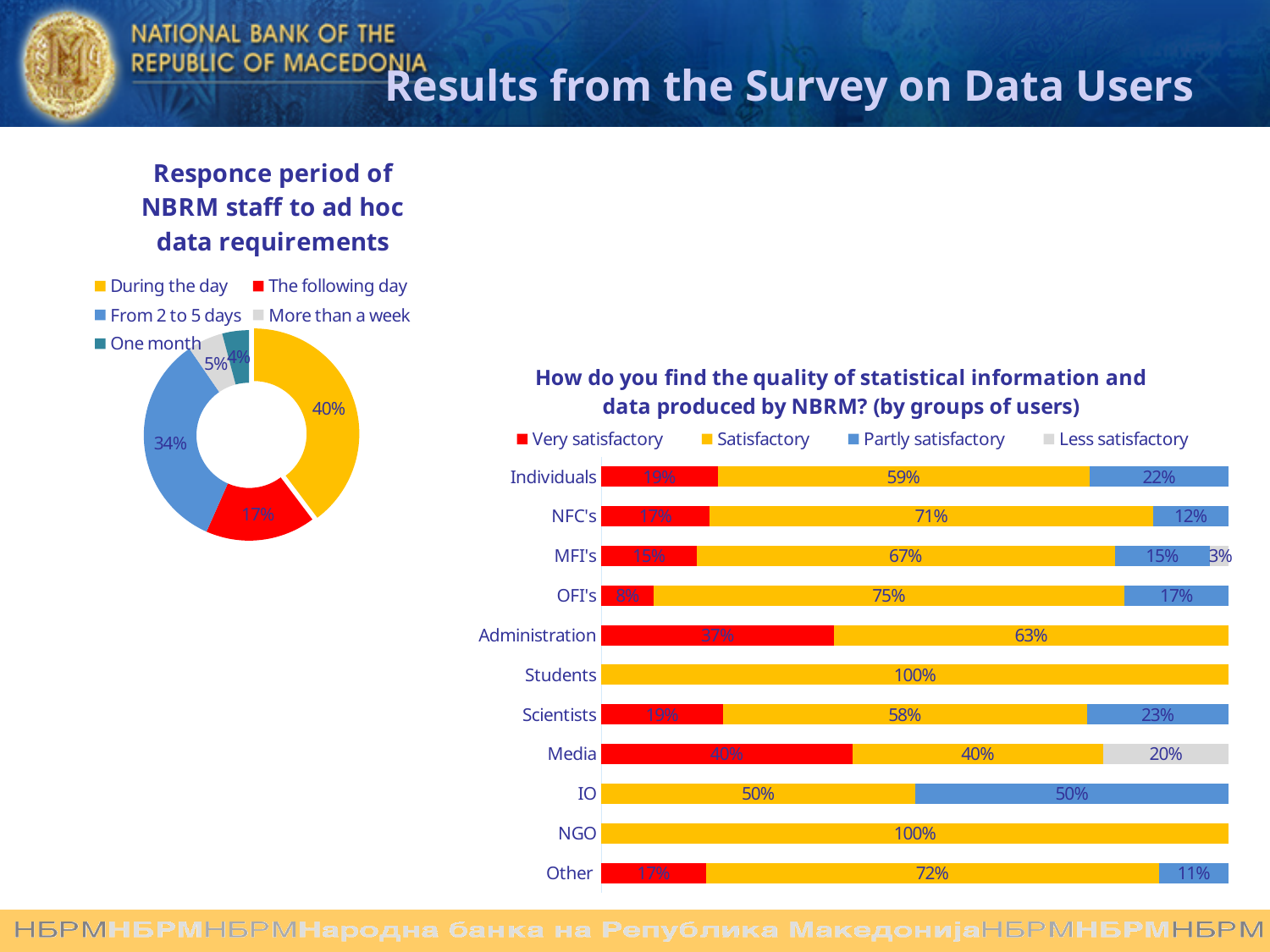
What type of chart is shown on the right of the slide? Stacked bar chart In the stacked bar chart on the right, which group has the highest 'Satisfactory' value among Individuals, NFC's, MFI's and OFI's? OFI's In the stacked bar chart on the right, is the 'Very satisfactory' value for Media larger or smaller than that for Scientists? larger In the doughnut chart on the left, which response period has the smallest share? One month In the doughnut chart on the left, how many legend entries are listed? 5 In the stacked bar chart on the right, what is the 'Very satisfactory' value for Administration? 37% In the doughnut chart on the left, what share of responses is 'During the day'? 40% In the stacked bar chart on the right, what is the 'Satisfactory' value for NFC's? 71% In the stacked bar chart on the right, how many user groups are shown? 11 In the doughnut chart on the left, what is the difference between the 'During the day' share and 'The following day' share? 23% In the doughnut chart on the left, what share of responses is 'From 2 to 5 days'? 34% In the stacked bar chart on the right, what is the 'Less satisfactory' value for Media? 20%